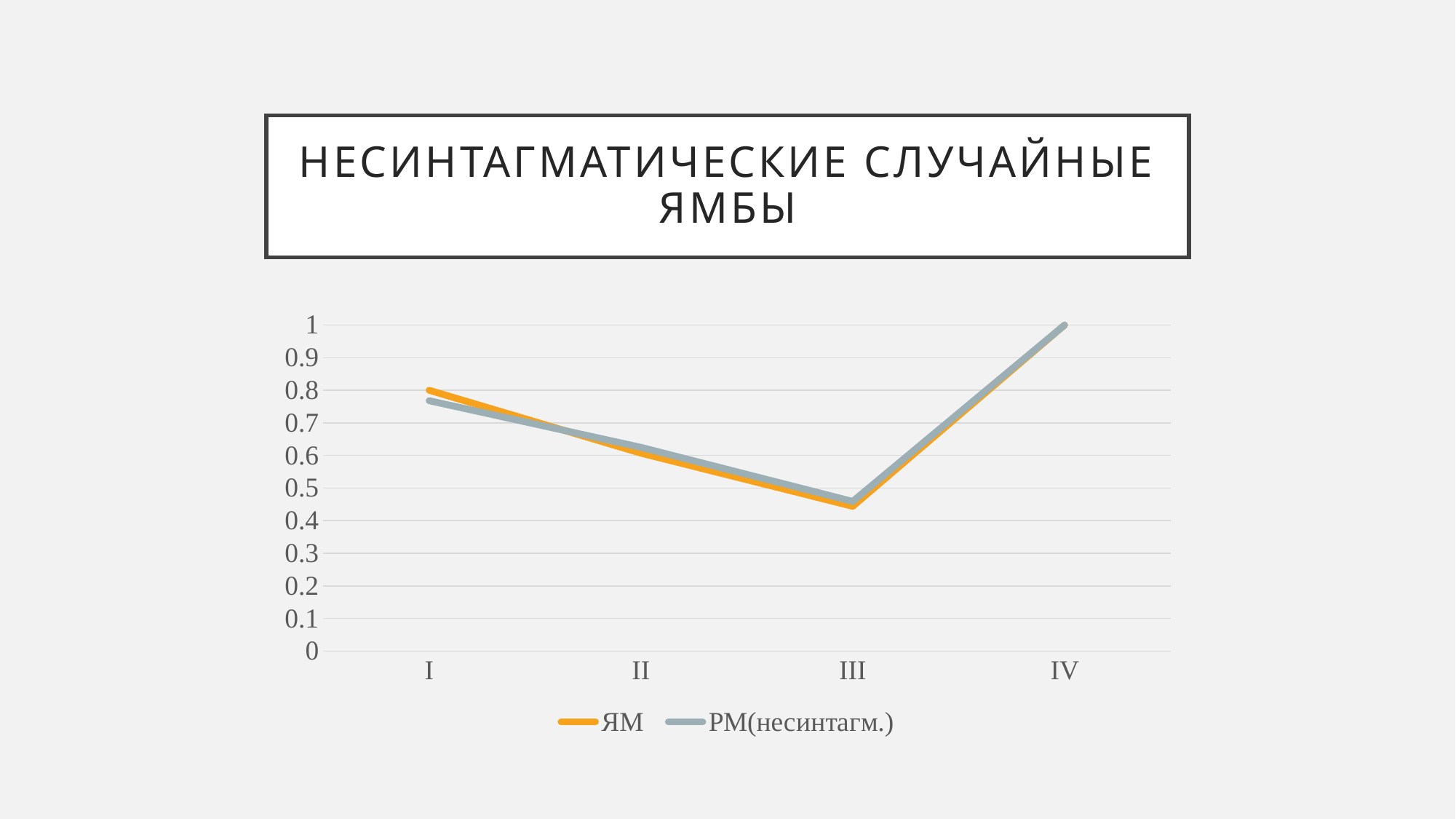
How many categories are shown on the x axis? 4 What is the value of the РМ(несинтагм.) series at category IV? 1 Is the value of the ЯМ series at category III greater or less than 0.5? less At which category does the РМ(несинтагм.) series reach its lowest value? III At which category does the ЯМ series reach its highest value? IV How many series does the legend list? 2 What is the value of the ЯМ series at category IV? 1 Do the values of the ЯМ series rise or fall from category I to category III? fall At which category does the ЯМ series reach its lowest value? III Is the value of the РМ(несинтагм.) series at category I greater or less than 0.7? greater What kind of chart is shown on the slide? line chart Which colour is used for the ЯМ series line? orange